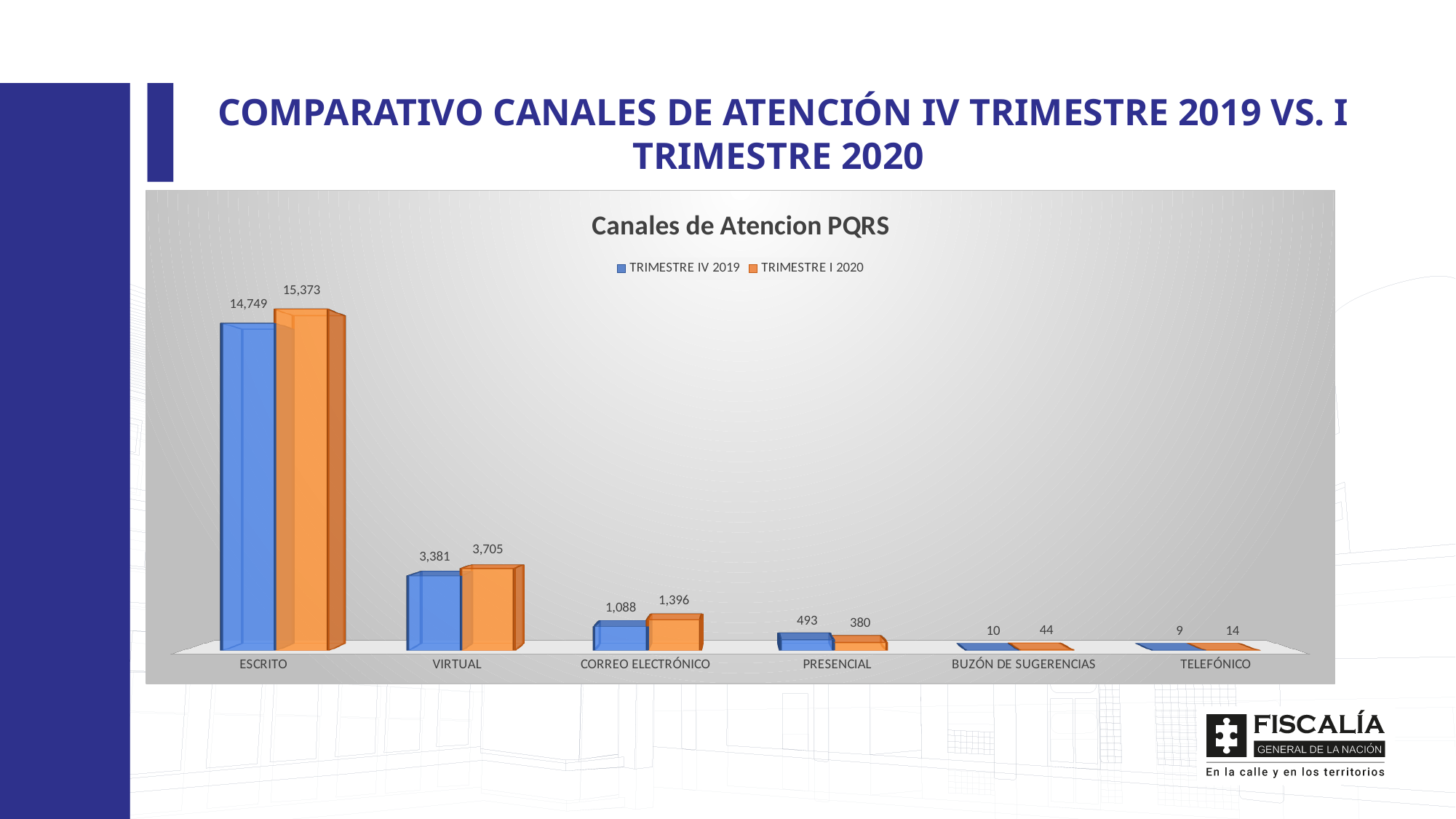
For PRESENCIAL, which series has the larger value, TRIMESTRE IV 2019 or TRIMESTRE I 2020? TRIMESTRE IV 2019 What is the value for VIRTUAL in the TRIMESTRE IV 2019 series? 3,381 What kind of chart is shown on the slide? Bar chart What is the value for ESCRITO in the TRIMESTRE I 2020 series? 15,373 What is the title of the chart? Canales de Atencion PQRS What is the difference between the TRIMESTRE I 2020 and TRIMESTRE IV 2019 values for ESCRITO? 624 How many categories are shown on the x axis? 6 Which category has the highest value in the TRIMESTRE IV 2019 series? ESCRITO How many series does the legend list? 2 What is the difference between the TRIMESTRE I 2020 and TRIMESTRE IV 2019 values for CORREO ELECTRÓNICO? 308 Which category has the lowest value in the TRIMESTRE IV 2019 series? TELEFÓNICO What is the value for PRESENCIAL in the TRIMESTRE I 2020 series? 380